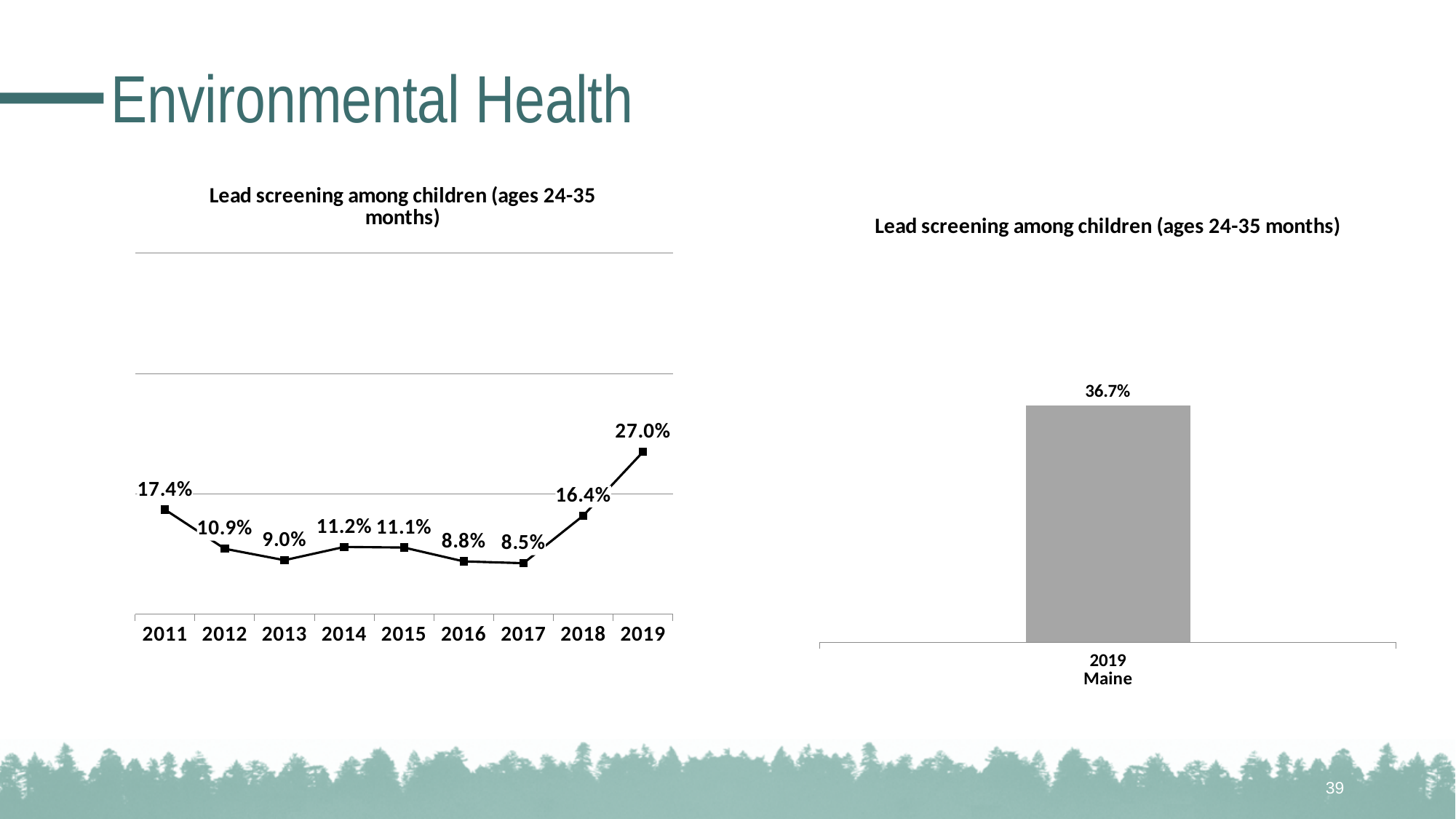
In the left chart, what was the lead screening rate among children in 2019? 27.0% In the left chart, what was the lead screening rate among children in 2011? 17.4% In the right chart, what was the lead screening rate for Maine in 2019? 36.7% In the left chart, which year had the highest lead screening rate? 2019 In the left chart, which year had a higher lead screening rate, 2011 or 2018? 2011 What type of chart is the left chart? line chart How many years are plotted in the left chart? 9 In the left chart, which year had the lowest lead screening rate? 2017 In the left chart, what is the difference between the 2019 and 2018 lead screening rates? 10.6% In the left chart, what was the lead screening rate among children in 2014? 11.2% In the left chart, did the lead screening rate rise or fall from 2017 to 2019? rise What type of chart is the right chart? bar chart